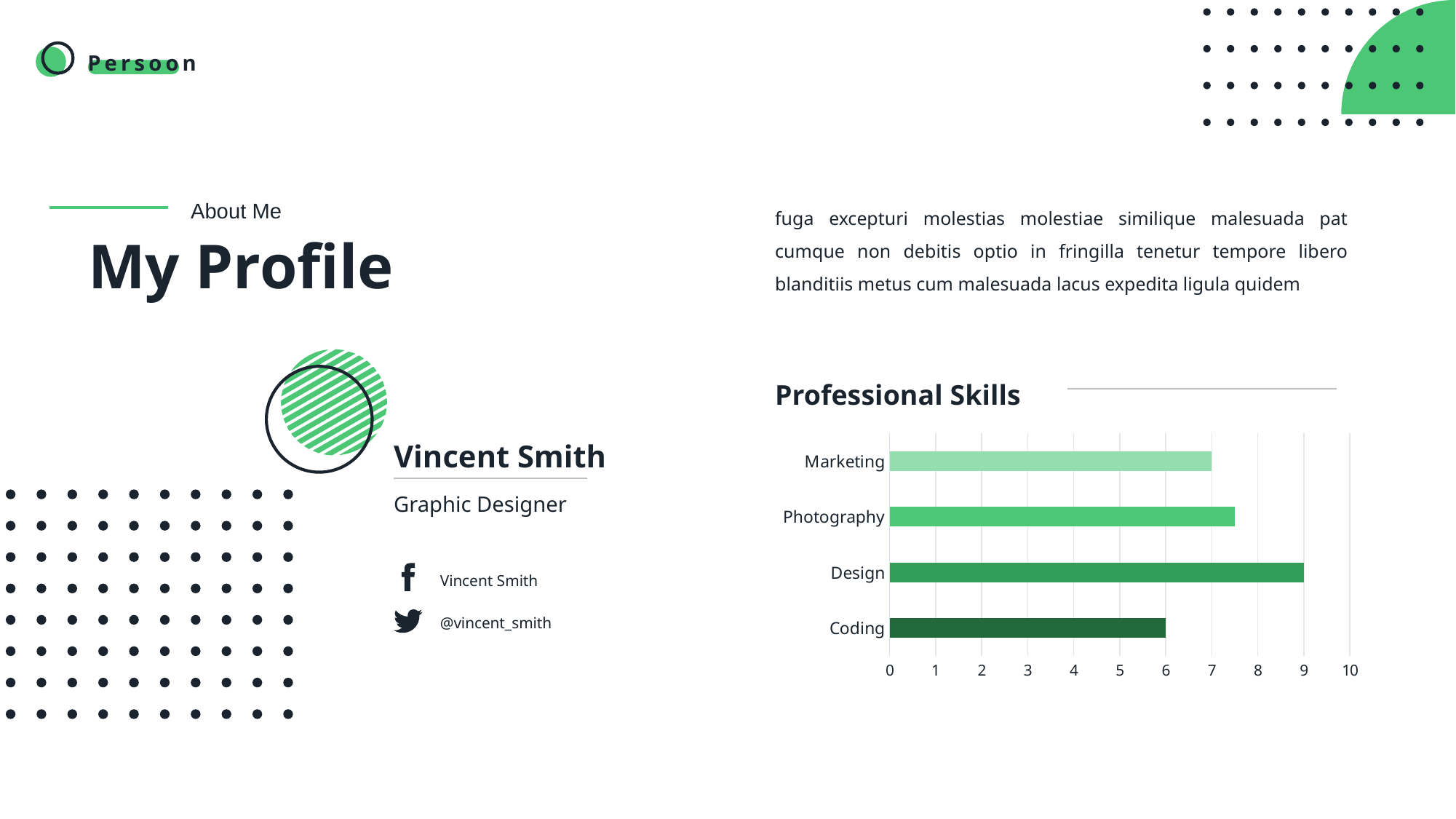
Which skill has the highest value in the Professional Skills chart? Design What is the difference between the values for Design and Coding in the Professional Skills chart? 3 Is the value for Photography in the Professional Skills chart greater or less than 8? less What kind of chart is shown under the heading Professional Skills? bar chart What is the value for Design in the Professional Skills chart? 9 Which skill has the lowest value in the Professional Skills chart? Coding What is the highest value shown on the horizontal axis of the Professional Skills chart? 10 Which is larger in the Professional Skills chart, Photography or Marketing? Photography Is the value for Design in the Professional Skills chart greater or less than 8? greater What is the value for Marketing in the Professional Skills chart? 7 What is the value for Coding in the Professional Skills chart? 6 How many skill categories are plotted in the Professional Skills chart? 4